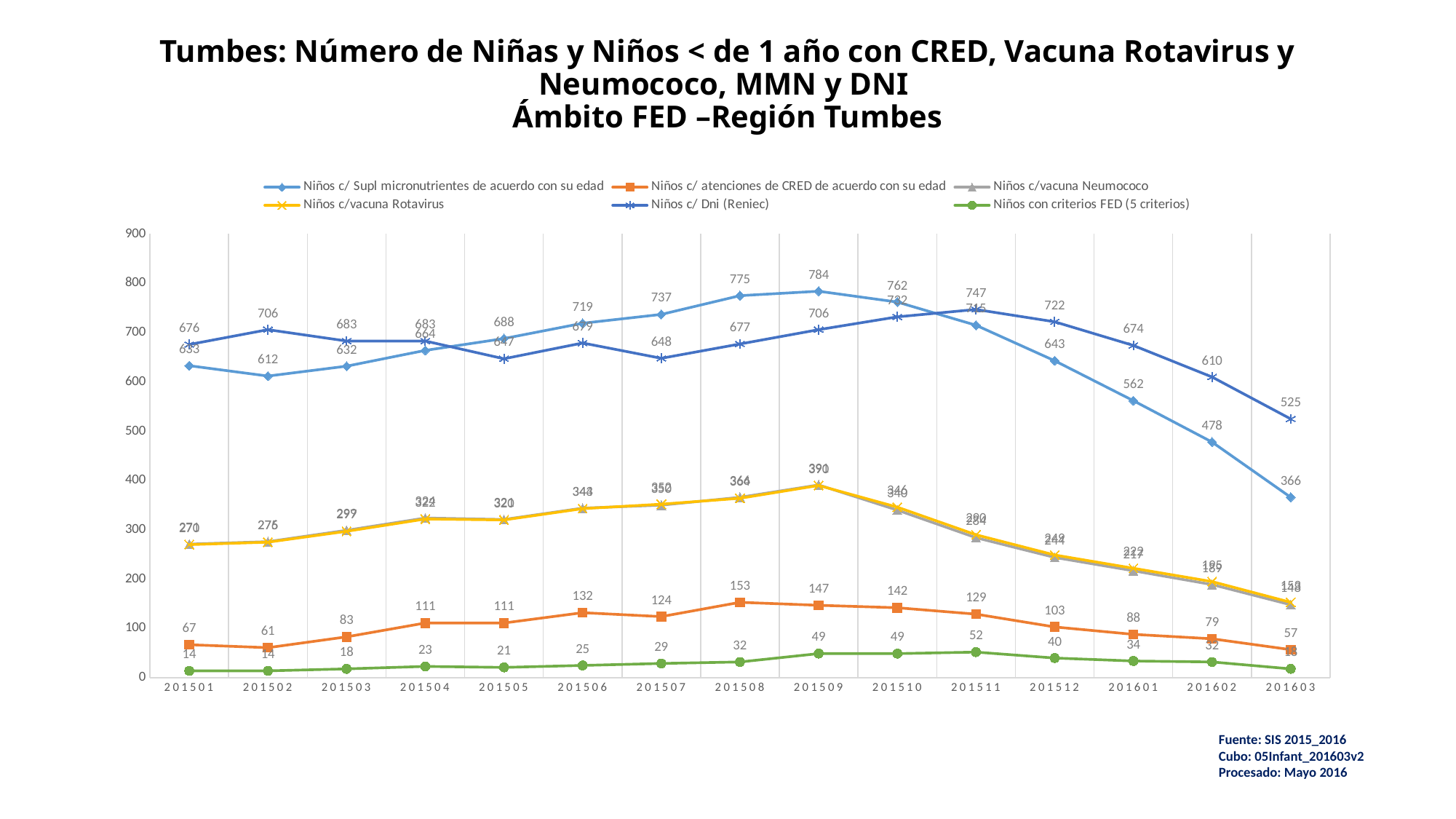
How many series does the legend list? 6 What is the value for 'Niños c/ Supl micronutrientes de acuerdo con su edad' in 201509? 784 In 201603, which is larger: 'Niños c/ Dni (Reniec)' or 'Niños c/ Supl micronutrientes de acuerdo con su edad'? Niños c/ Dni (Reniec) What is the value for 'Niños con criterios FED (5 criterios)' in 201511? 52 What is the difference between the 'Niños c/ Supl micronutrientes de acuerdo con su edad' values in 201509 and 201603? 418 What kind of chart is shown on the slide? line chart In which period is 'Niños c/ atenciones de CRED de acuerdo con su edad' at its lowest? 201603 From 201509 to 201603, does 'Niños c/ Supl micronutrientes de acuerdo con su edad' rise or fall? fall What is the value for 'Niños c/ atenciones de CRED de acuerdo con su edad' in 201508? 153 How many periods are shown along the x axis? 15 In which period does 'Niños c/ Supl micronutrientes de acuerdo con su edad' reach its highest value? 201509 What is the value for 'Niños c/ Dni (Reniec)' in 201603? 525